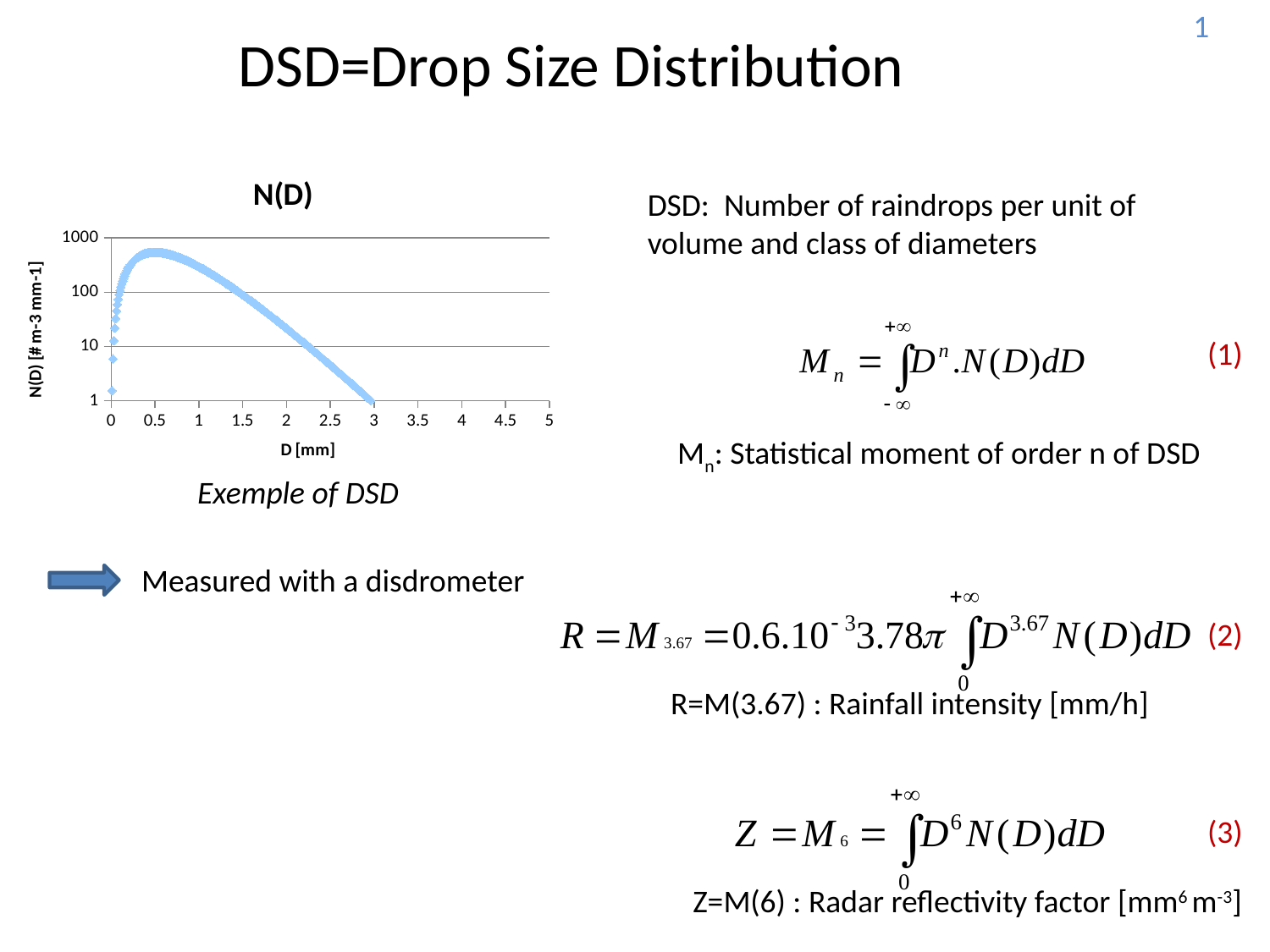
Is the value of N(D) at D = 2 greater or less than 10? greater What is the title of the chart? N(D) What is the largest tick value shown on the x axis of the chart? 5 Between D = 1 and D = 3, do the values of N(D) rise or fall as D increases? fall Which has the larger N(D) value, D = 0.5 or D = 2.5? D = 0.5 Is the value of N(D) at D = 2.5 greater or less than 10? less Is the value of N(D) at D = 1 greater or less than 100? greater What is the label of the x axis of the chart? D [mm] What kind of chart is shown on the slide? scatter chart Which has the larger N(D) value, D = 1 or D = 2? D = 1